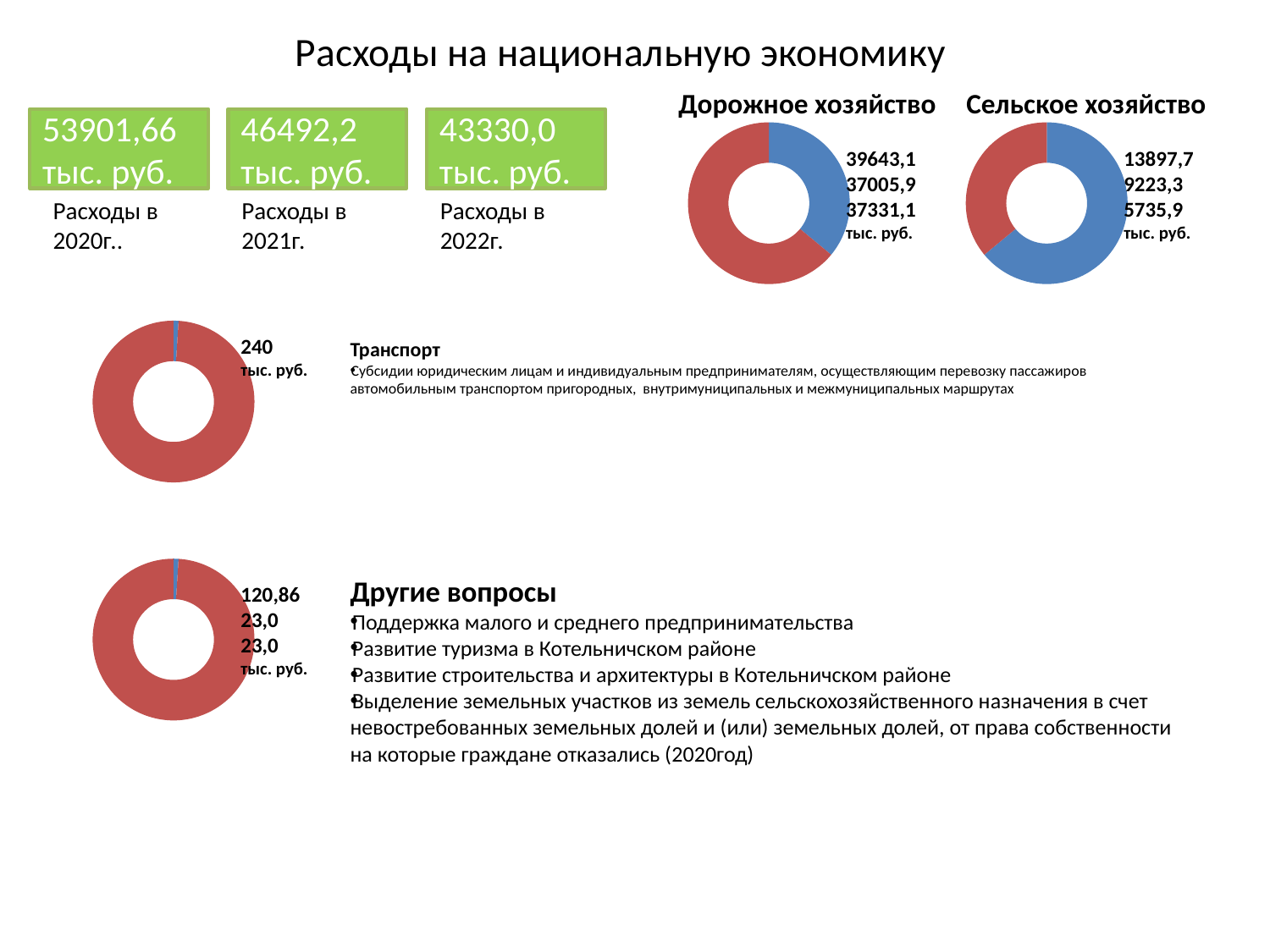
What is the first value listed next to the Другие вопросы doughnut chart? 120,86 What kind of chart is the Дорожное хозяйство chart? doughnut chart In the Транспорт chart (the doughnut next to the 240 тыс. руб. label), which colour fills almost the entire ring? red In the Дорожное хозяйство chart, which slice is larger, the red one or the blue one? red How many slices does the Сельское хозяйство doughnut chart have? 2 What is the first value listed next to the Дорожное хозяйство chart? 39643,1 What is the title of the slide containing the charts? Расходы на национальную экономику What is the difference between the first two values listed next to the Сельское хозяйство chart, 13897,7 and 9223,3? 4674,4 How many doughnut charts are shown on the slide? 4 In the Сельское хозяйство chart, which slice is larger, the red one or the blue one? blue What is the first value listed next to the Сельское хозяйство chart? 13897,7 What value is printed next to the Транспорт doughnut chart? 240 тыс. руб.